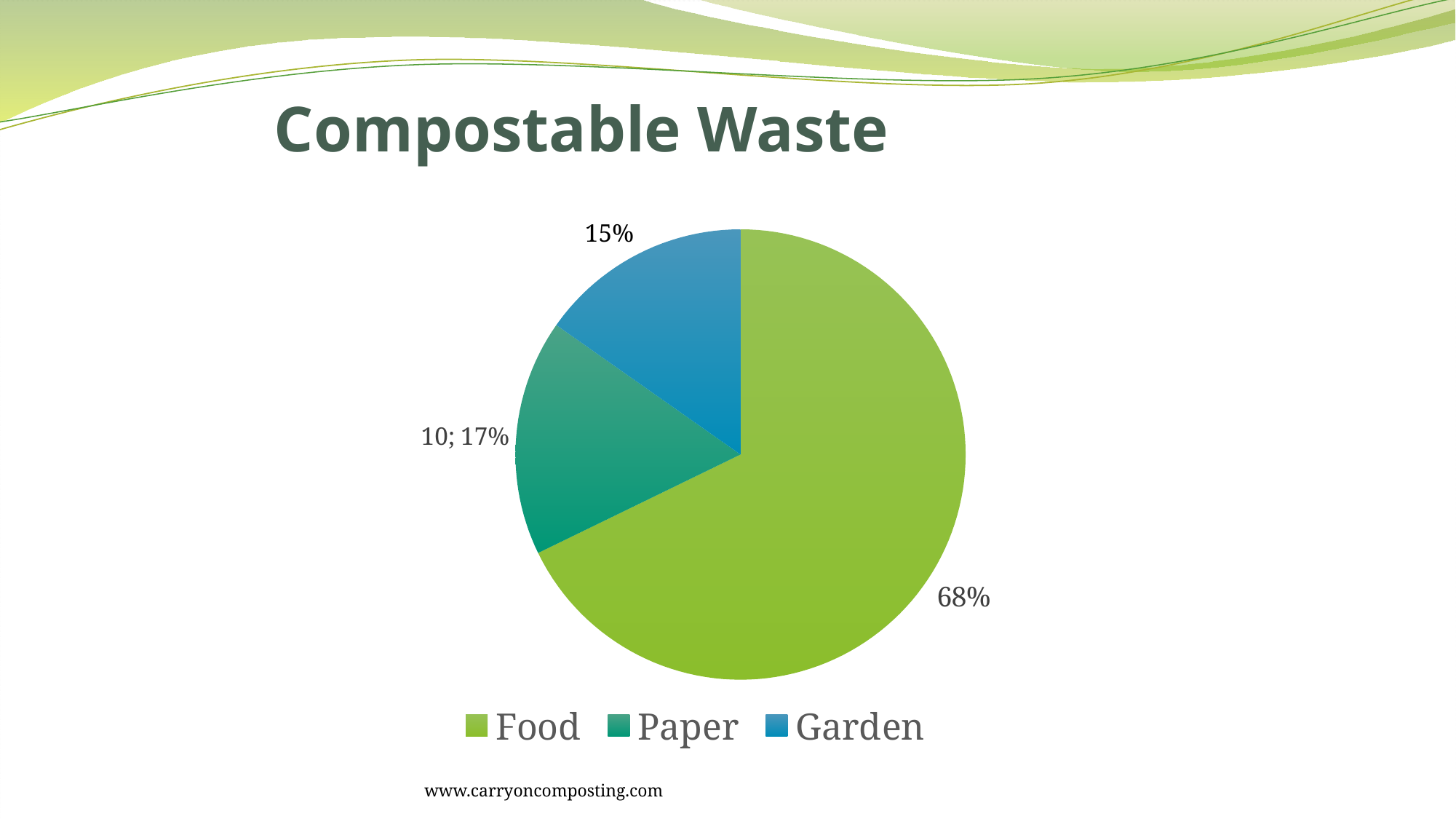
What kind of chart is shown on the slide? pie chart Which category has the largest slice of the pie? Food Which categories are listed in the legend? Food, Paper, Garden What is the combined share of the Paper and Garden slices? 32% How many slices does the pie chart have? 3 Which slice is larger, Paper or Garden? Paper What is the title of the chart? Compostable Waste What percentage is shown for the Paper slice? 17% What is the difference in percentage points between the Food slice and the Garden slice? 53 What share of compostable waste is Garden? 15% What share of compostable waste is Food? 68% Which category has the smallest slice of the pie? Garden